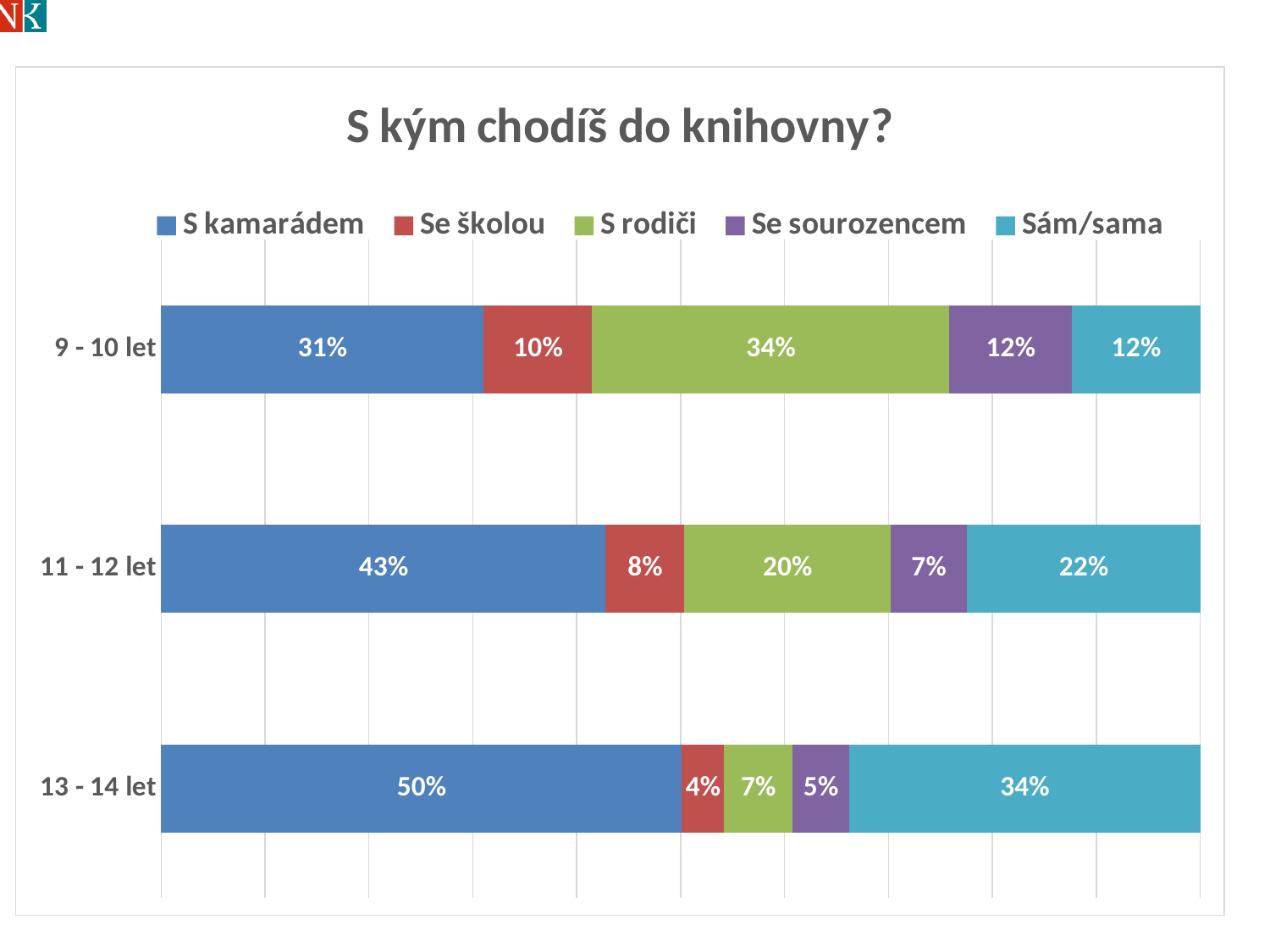
What is the value for "Se školou" in the "13 - 14 let" category? 4% What is the value for "S kamarádem" in the "13 - 14 let" category? 50% Which is larger: "Se sourozencem" for "9 - 10 let" or "Se sourozencem" for "11 - 12 let"? 9 - 10 let What is the difference between the "Sám/sama" values for "13 - 14 let" and "9 - 10 let"? 22% What is the title of the chart? S kým chodíš do knihovny? What is the value for "Sám/sama" in the "11 - 12 let" category? 22% Which age category has the lowest value for "S rodiči"? 13 - 14 let Which age category has the highest value for "S kamarádem"? 13 - 14 let What kind of chart is shown on the slide? Stacked bar chart How many series does the legend list? 5 How many age categories are shown on the chart? 3 What is the value for "S rodiči" in the "9 - 10 let" category? 34%